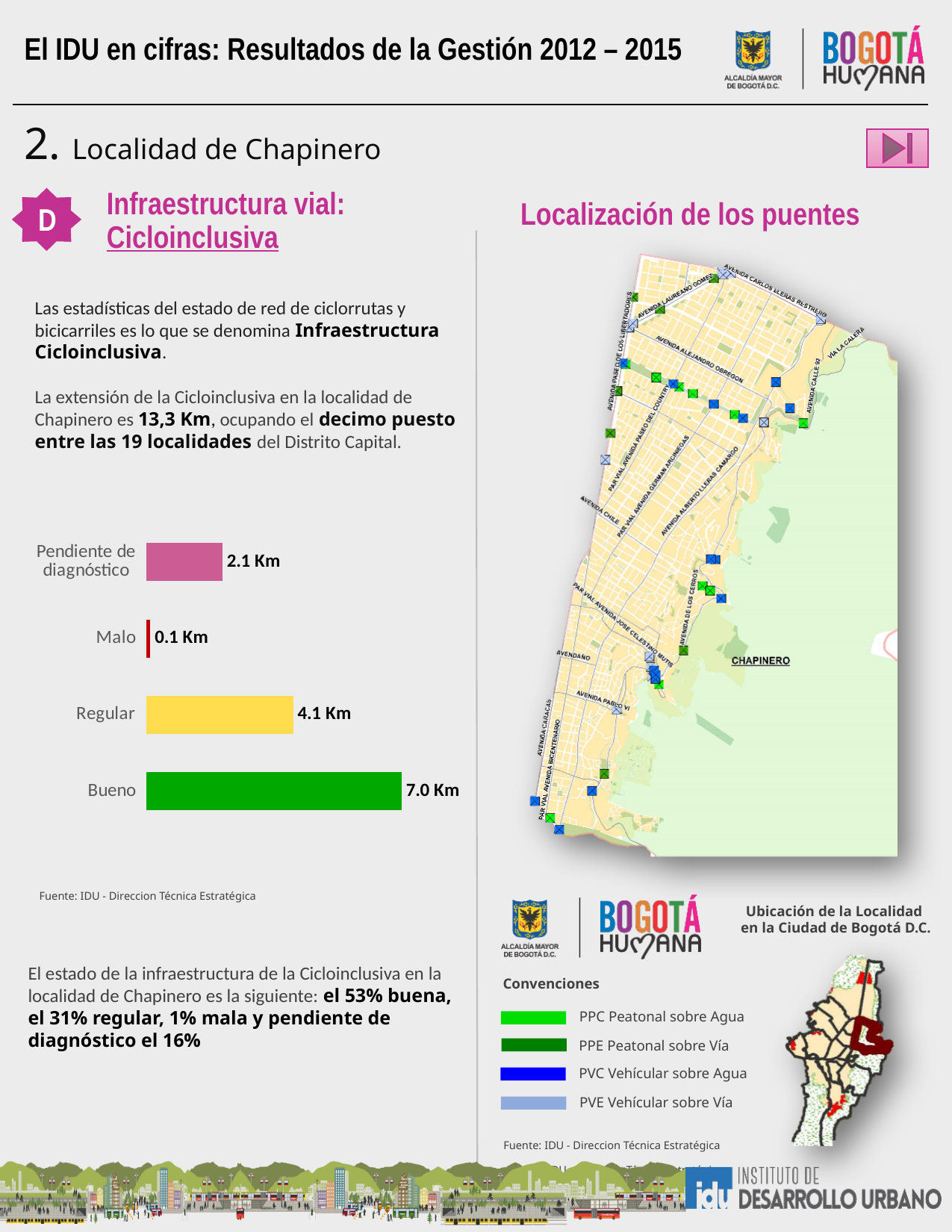
What is the value for Malo in the bar chart? 0.1 Km How many categories are shown in the bar chart? 4 What is the difference between the values for Bueno and Regular in the bar chart? 2.9 Km What is the value for Bueno in the bar chart? 7.0 Km What colour is the bar for Bueno in the bar chart? Green Which category has the highest value in the bar chart? Bueno What is the value for Regular in the bar chart? 4.1 Km Which category has the lowest value in the bar chart? Malo Which is larger in the bar chart, Regular or Pendiente de diagnóstico? Regular What is the value for Pendiente de diagnóstico in the bar chart? 2.1 Km What is the difference between the values for Pendiente de diagnóstico and Malo in the bar chart? 2.0 Km What kind of chart is shown on the left of the slide? Bar chart